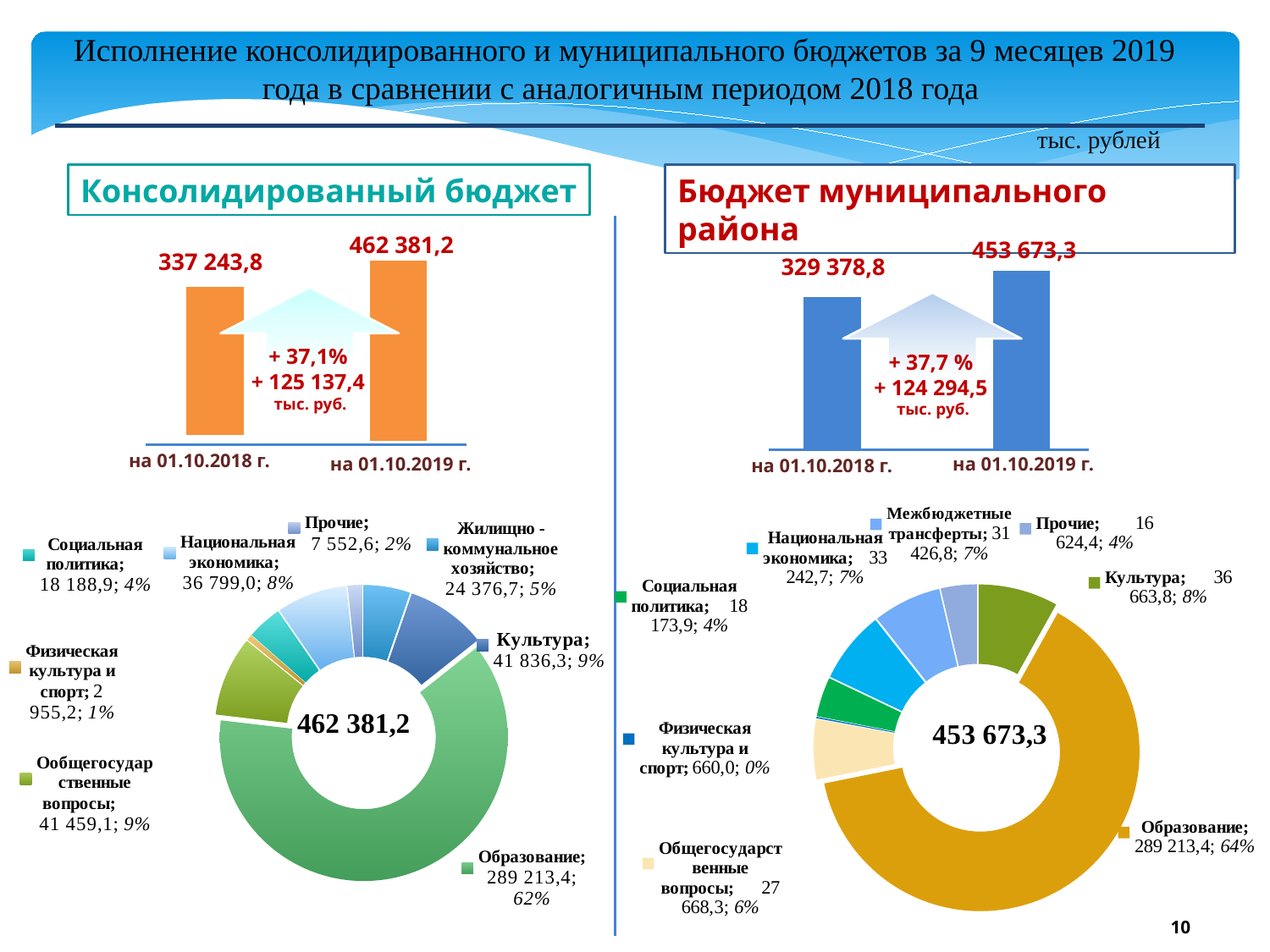
In the doughnut chart under 'Консолидированный бюджет', what share does 'Образование' have? 62% In the 'Бюджет муниципального района' bar chart, what is the value for 'на 01.10.2019 г.'? 453 673,3 In the 'Консолидированный бюджет' bar chart, do the values rise or fall from 01.10.2018 to 01.10.2019? rise In the doughnut chart under 'Бюджет муниципального района', how many categories are shown? 8 In the doughnut chart under 'Бюджет муниципального района', what is the value for 'Межбюджетные трансферты'? 31 426,8 In the doughnut chart under 'Консолидированный бюджет', what is the value for 'Культура'? 41 836,3 In the doughnut chart under 'Консолидированный бюджет', which category has the largest share? Образование In the 'Консолидированный бюджет' bar chart, what is the value for 'на 01.10.2018 г.'? 337 243,8 In the doughnut chart under 'Бюджет муниципального района', which is larger: 'Культура' or 'Общегосударственные вопросы'? Культура In the 'Бюджет муниципального района' bar chart, what is the difference between the 2019 and 2018 values? 124 294,5 In the 'Консолидированный бюджет' bar chart, what is the value for 'на 01.10.2019 г.'? 462 381,2 In the doughnut chart under 'Консолидированный бюджет', which category has the smallest value? Физическая культура и спорт